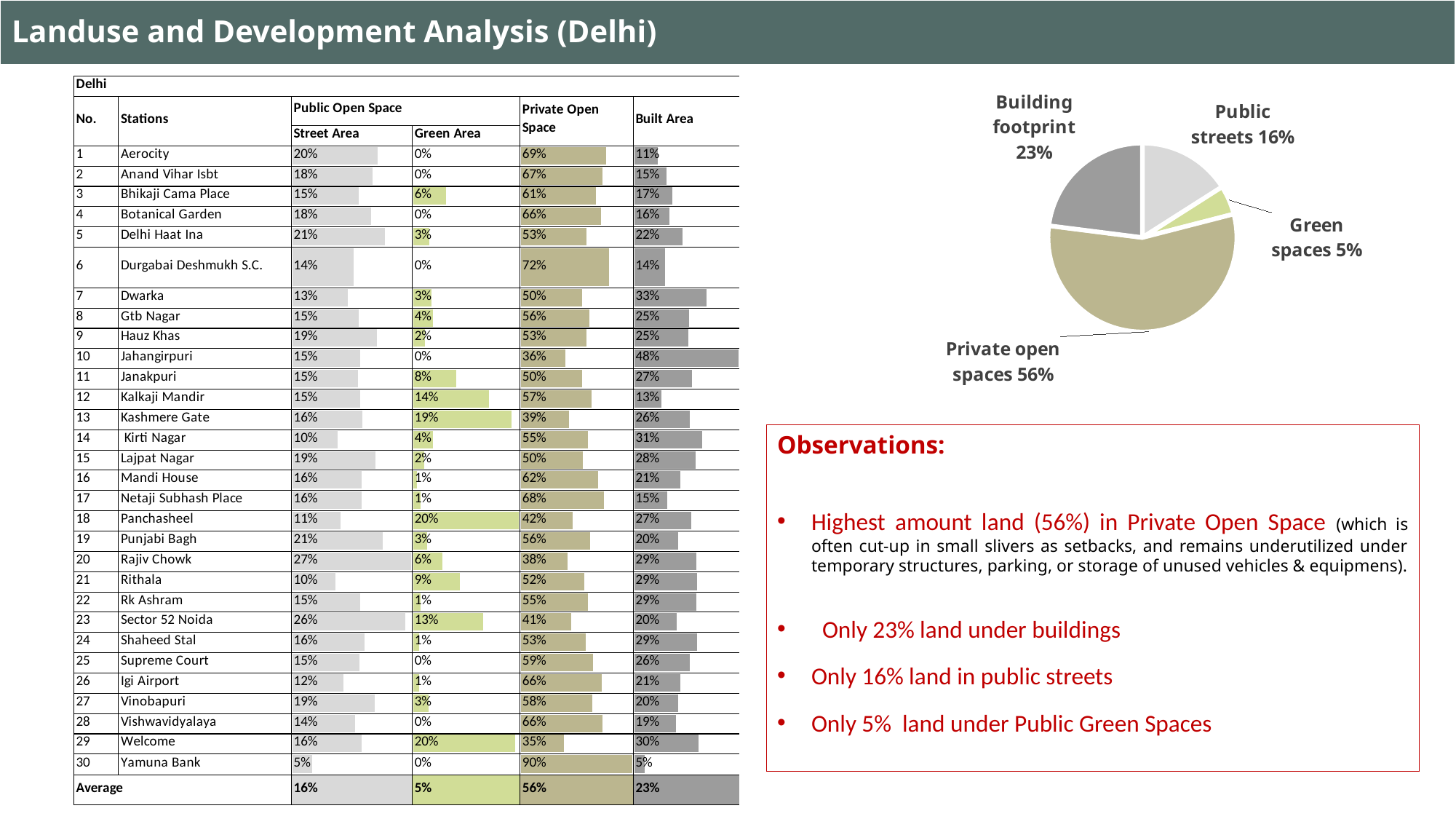
Which slice of the pie chart is the largest? Private open spaces In the pie chart, what is the difference between the Private open spaces share and the Building footprint share? 33 percentage points How many slices does the pie chart have? 4 In the pie chart, what is the combined share of Public streets and Green spaces? 21% In the pie chart, what share is labelled for Private open spaces? 56% Which slice of the pie chart is the smallest? Green spaces In the pie chart, what share is labelled for Building footprint? 23% What kind of chart is shown on the right side of the slide? pie chart In the pie chart, what share is labelled for Public streets? 16% In the pie chart, what colour is the Private open spaces slice? khaki/olive tan In the pie chart, which is larger: Building footprint or Public streets? Building footprint In the pie chart, what share is labelled for Green spaces? 5%